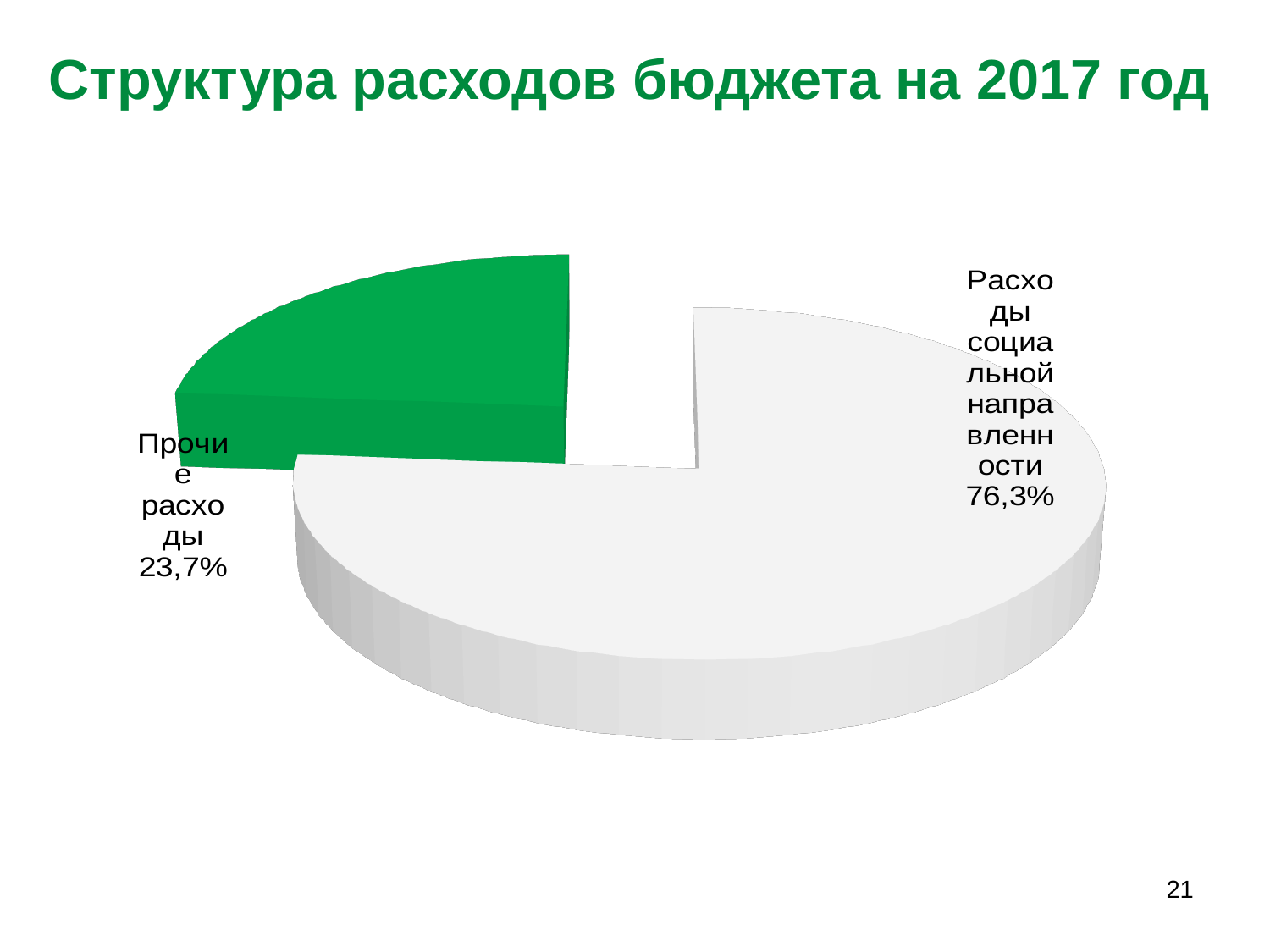
What share of the pie is labelled "Расходы социальной направленности"? 76,3% What is the difference in percentage points between the "Расходы социальной направленности" slice and the "Прочие расходы" slice? 52,6 What share of the pie is labelled "Прочие расходы"? 23,7% Which is larger: the "Прочие расходы" slice or the "Расходы социальной направленности" slice? Расходы социальной направленности What colour is the "Прочие расходы" slice? Green What is the total of the two slice percentages shown? 100% Which slice of the pie is the smallest? Прочие расходы What kind of chart is shown on the slide? Pie chart What is the title of the slide? Структура расходов бюджета на 2017 год Is the share for "Прочие расходы" greater or less than 50%? less Which slice of the pie is the largest? Расходы социальной направленности How many slices does the pie chart have? 2